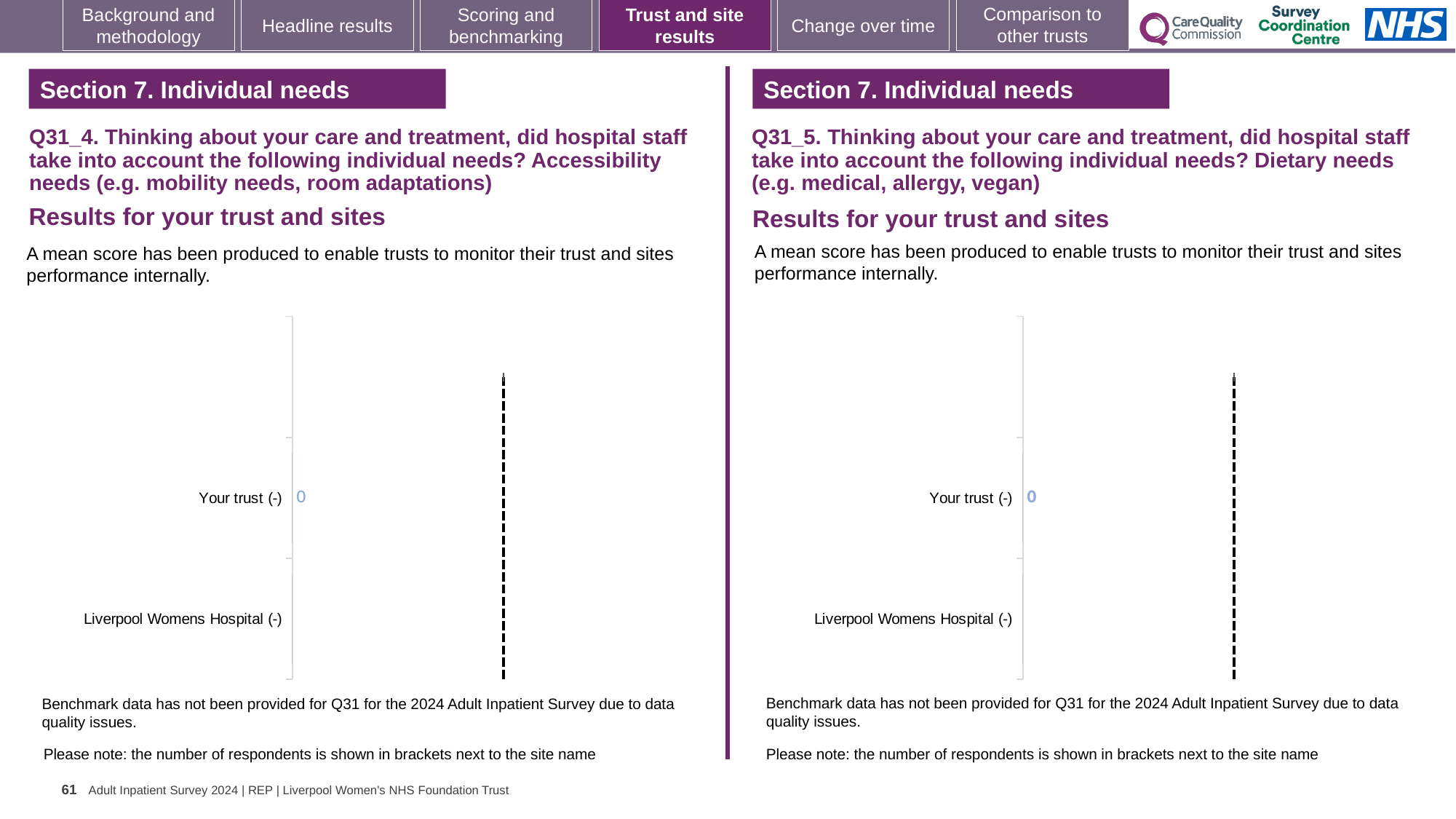
On the left chart (Q31_4, Accessibility needs), what is the label of the category listed below Your trust? Liverpool Womens Hospital (-) On the right chart (Q31_5, Dietary needs), which category has a printed data label? Your trust (-) On the left chart (Q31_4, Accessibility needs), how many categories are listed on the vertical axis? 2 On the left chart (Q31_4, Accessibility needs), what is the value shown for Your trust? 0 On the right chart (Q31_5, Dietary needs), what is the value shown for Your trust? 0 On the right chart (Q31_5, Dietary needs), how many categories are listed on the vertical axis? 2